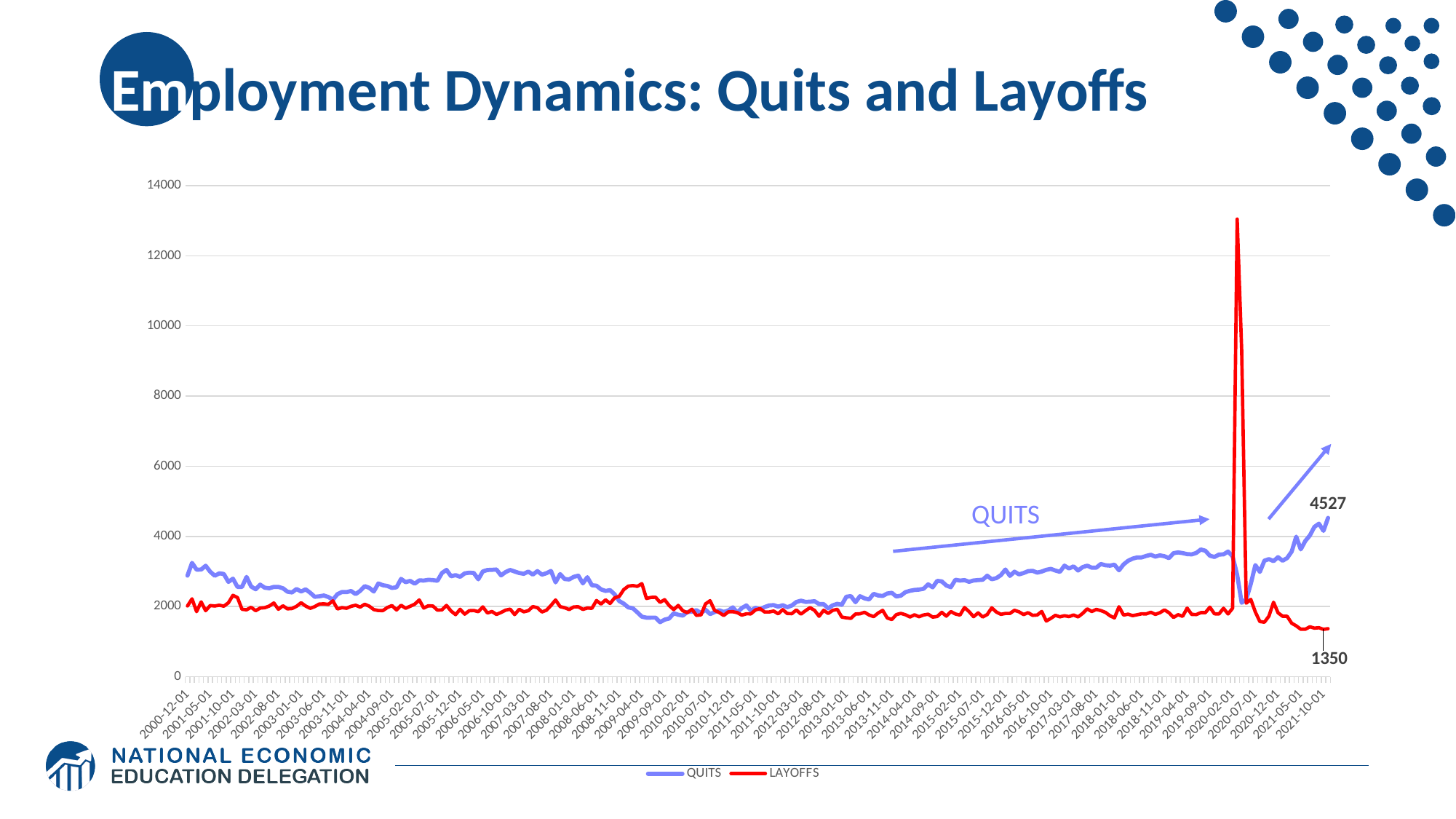
Is the value of the QUITS series at 2000-12-01 greater or less than 2000? greater What kind of chart is shown on the slide? line chart At the end of the series, which is larger: QUITS or LAYOFFS? QUITS Is the peak value of the LAYOFFS series in 2020 greater or less than 12000? greater How many series does the legend list? 2 What is the difference between the labelled final QUITS value and the labelled final LAYOFFS value? 3177 What is the labelled final value of the LAYOFFS series? 1350 What is the title of the slide? Employment Dynamics: Quits and Layoffs Does the QUITS series generally rise or fall between 2013 and 2019? rise Is the value of the LAYOFFS series at 2000-12-01 greater or less than 4000? less What is the labelled final value of the QUITS series? 4527 Which series reaches the highest peak on the chart? LAYOFFS